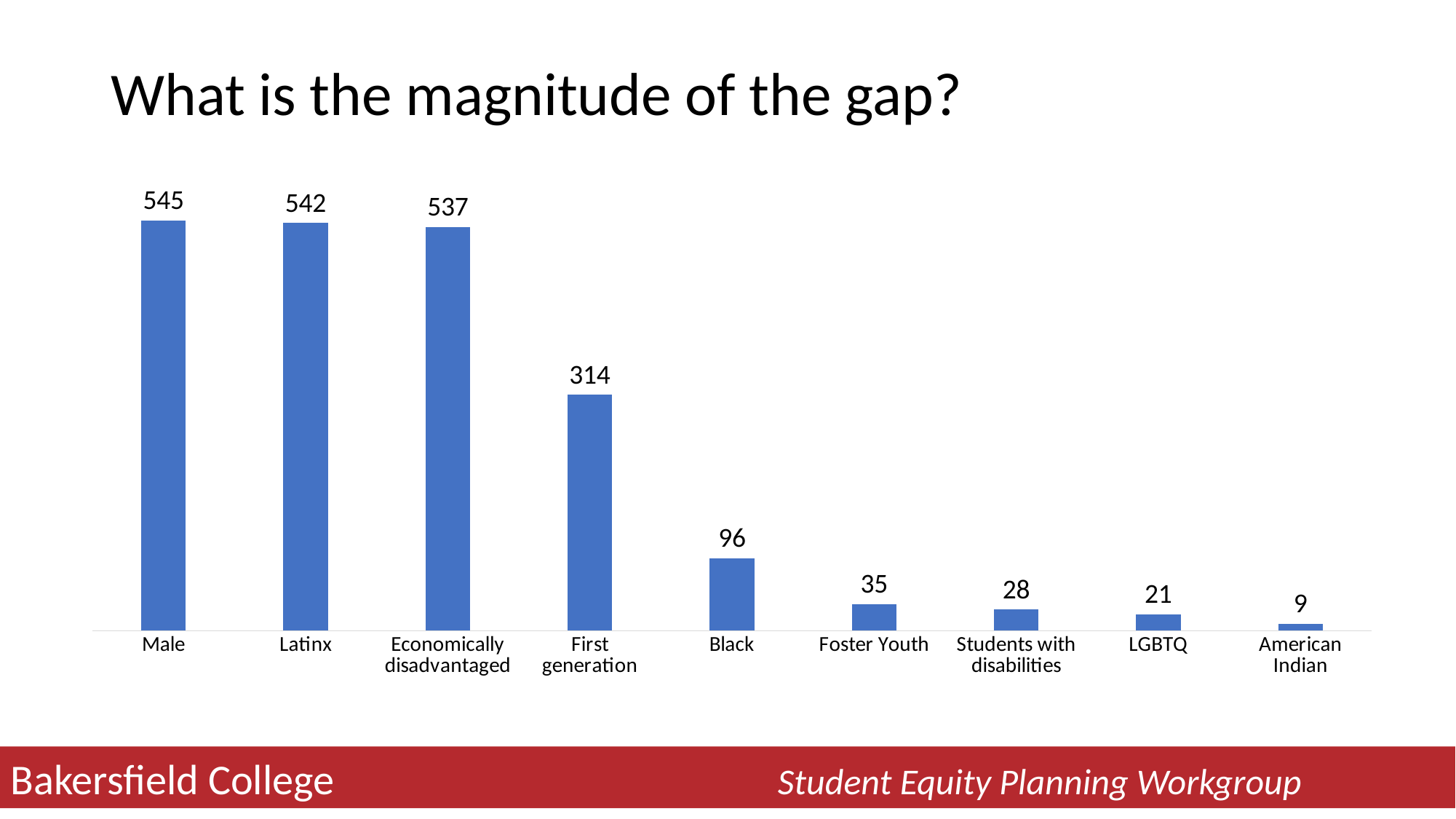
What is the title of the slide containing the chart? What is the magnitude of the gap? Which is larger, the value for Black or the value for Foster Youth? Black What is the value for Foster Youth? 35 What is the difference between the values for Male and Latinx? 3 What is the difference between the values for First generation and Black? 218 Which category has the lowest value? American Indian What is the value for LGBTQ? 21 What kind of chart is shown on the slide? Bar chart What is the value for Male? 545 Which category has the highest value? Male What is the value for First generation? 314 How many categories are shown on the chart? 9